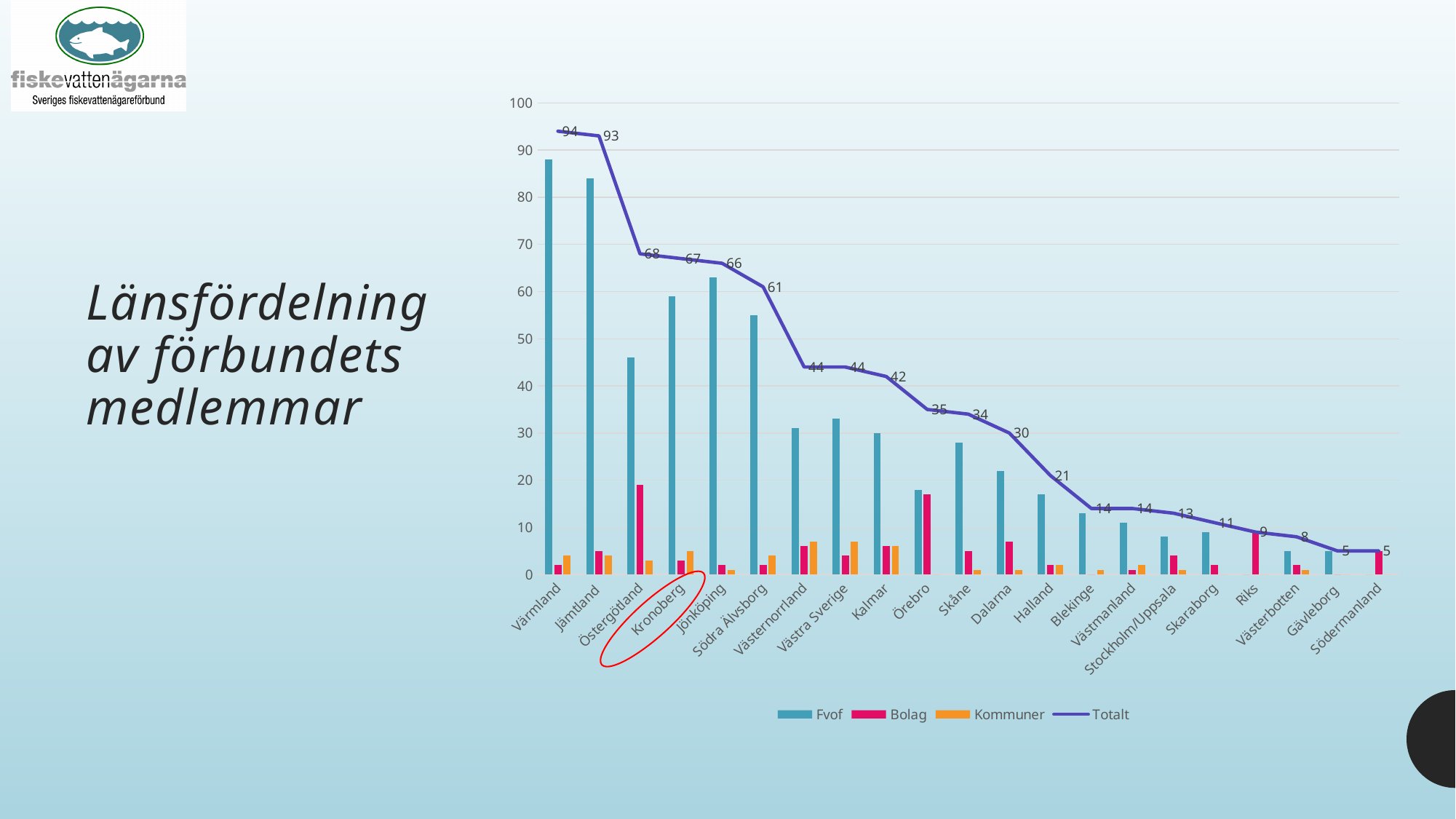
Which has a larger Totalt value, Södra Älvsborg or Västernorrland? Södra Älvsborg Is the Fvof value for Skåne greater or less than 30? less What is the Totalt value for Halland? 21 How many categories are shown on the x axis? 21 What is the difference between the Totalt values for Dalarna and Halland? 9 Which category has the highest Totalt value? Värmland Which category label is circled in red on the chart? Kronoberg Is the Fvof value for Värmland greater or less than 80? greater What is the Totalt value for Värmland? 94 Does the Totalt line rise or fall from left to right along the x axis? fall What is the Totalt value for Kronoberg? 67 How many series does the legend list? 4